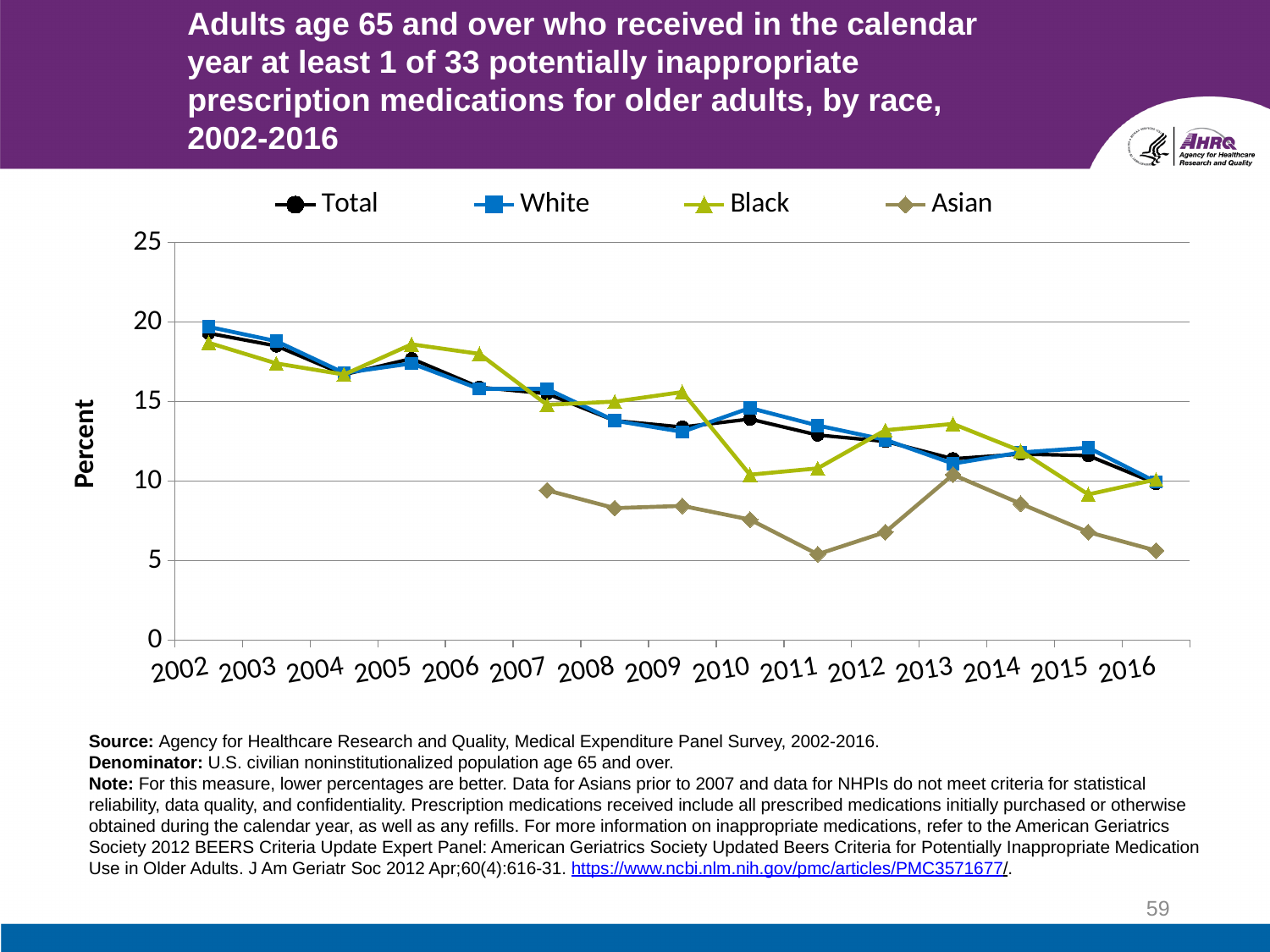
Does the Total series rise or fall from 2002 to 2016? fall How many years are shown on the x axis? 15 What is the label on the y axis? Percent In 2015, which is larger, the value for White or the value for Black? White Is the value for Asian in 2011 greater or less than 10? less In 2011, which is larger, the value for Black or the value for Asian? Black Which series has the lowest value in 2016? Asian What kind of chart is shown on the slide? line chart How many series does the legend list? 4 Is the value for Black in 2010 greater or less than 15? less Is the value for White in 2002 greater or less than 15? greater